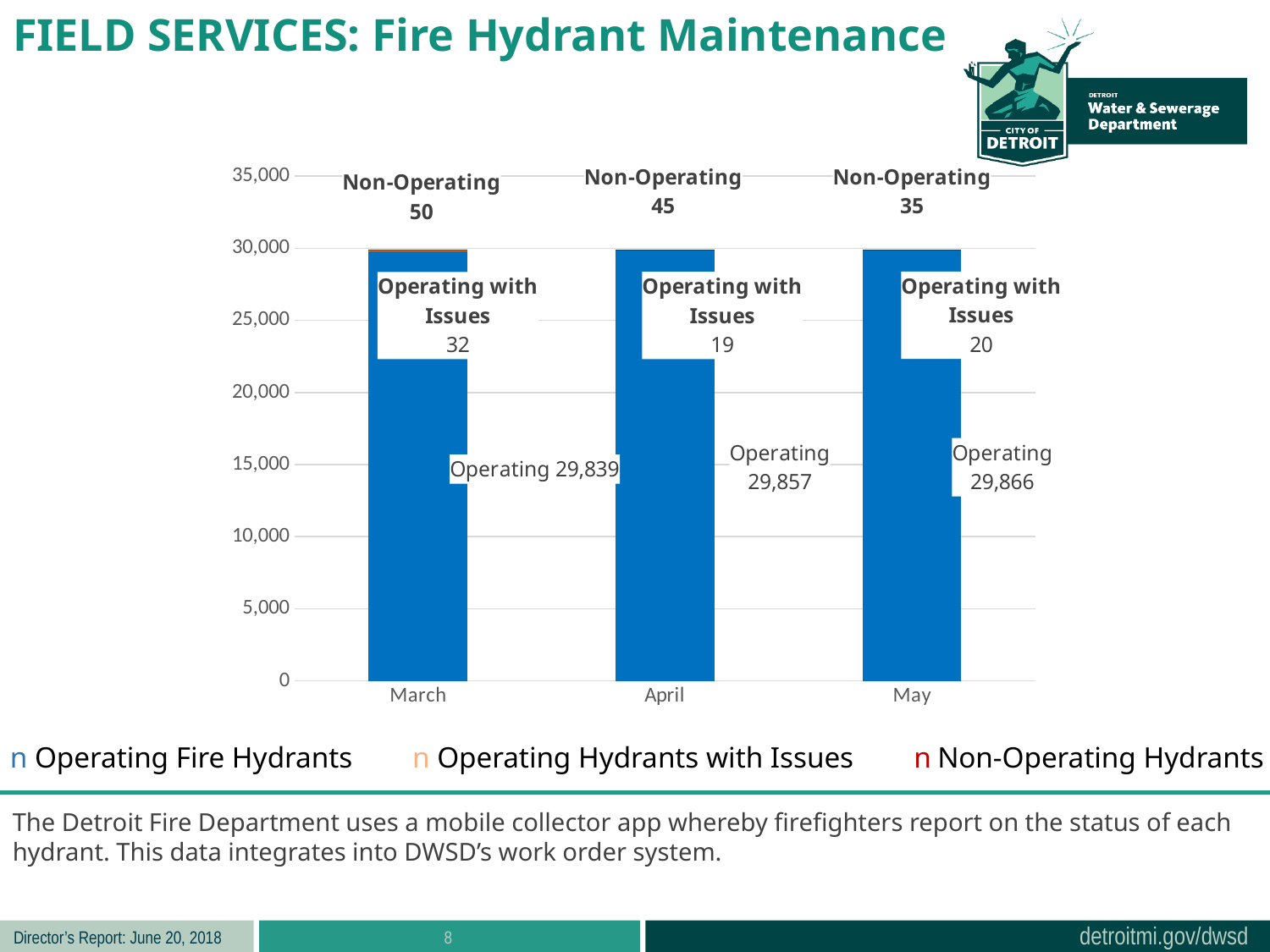
Which is larger, the Operating hydrant count in April or in May? May What is the number of Operating fire hydrants in March? 29,839 How many series does the legend list? 3 Do the Operating hydrant values rise or fall from March to May? Rise What is the difference between the Non-Operating hydrant counts in March and May? 15 How many months are shown on the x axis? 3 What kind of chart is shown on the slide? Stacked bar chart Which month has the lowest number of Operating hydrants with issues? April How many Non-Operating hydrants are shown for April? 45 What is the total number of hydrants in the March bar (all three series combined)? 29,921 Which month has the highest number of Non-Operating hydrants? March What is the value for Operating with Issues in May? 20